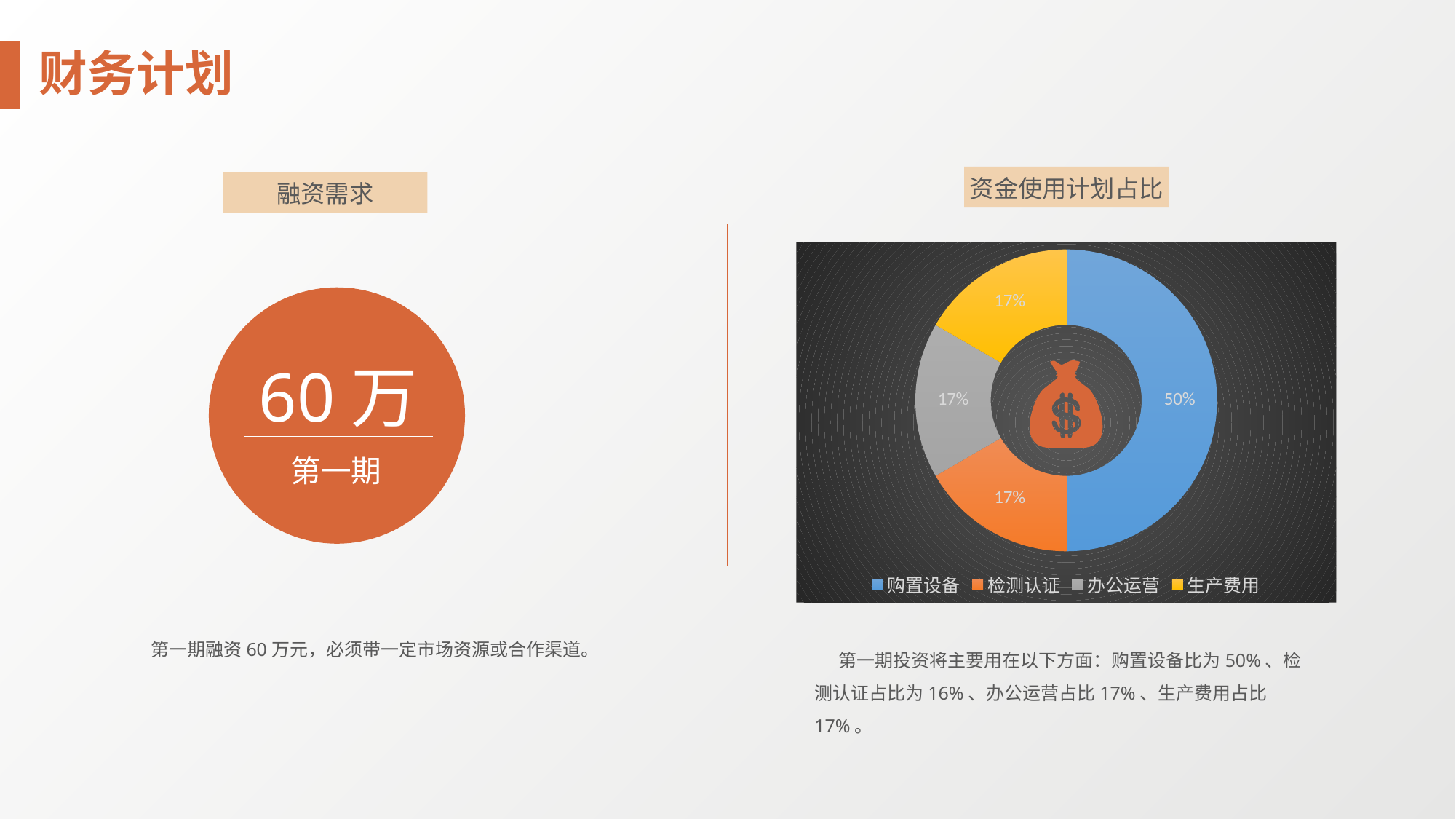
How many categories are shown in the 资金使用计划占比 chart? 4 What percentage of the 资金使用计划占比 chart is 购置设备? 50% In the 资金使用计划占比 chart, what is the difference between the share of 购置设备 and the share of 生产费用? 33% What percentage of the 资金使用计划占比 chart is 生产费用? 17% How many entries does the legend of the 资金使用计划占比 chart list? 4 What kind of chart is the 资金使用计划占比 chart? Doughnut (pie) chart What percentage of the 资金使用计划占比 chart is 办公运营? 17% In the 资金使用计划占比 chart, which is larger: the share of 购置设备 or the share of 办公运营? 购置设备 In the 资金使用计划占比 chart, which category is shown in yellow? 生产费用 What percentage of the 资金使用计划占比 chart is 检测认证? 17% What is the title of the chart on the slide? 资金使用计划占比 Which category has the largest share in the 资金使用计划占比 chart? 购置设备